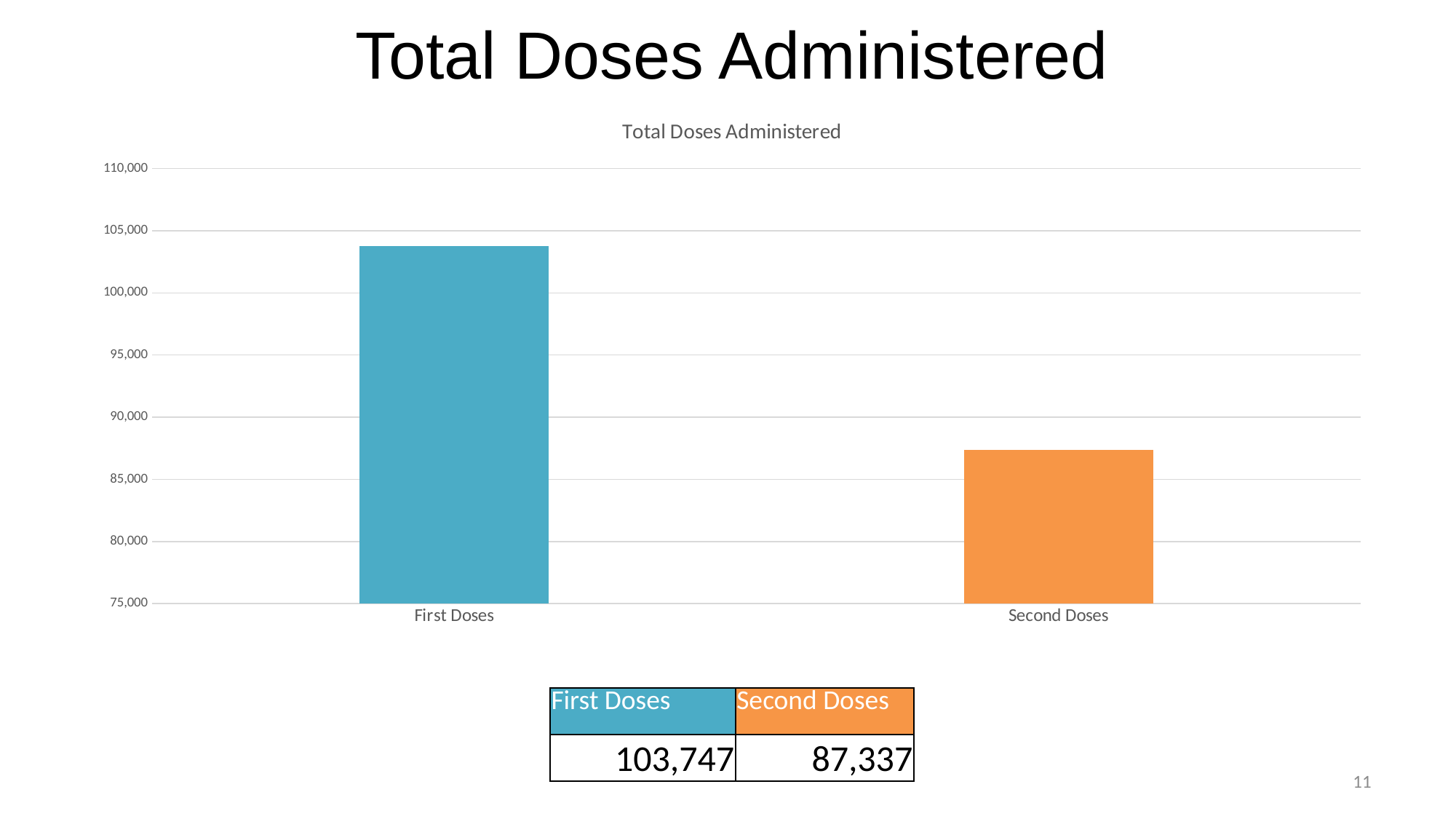
What colour is the bar for Second Doses? orange What is the title of the chart? Total Doses Administered What kind of chart is shown on the slide? bar chart Which is larger, First Doses or Second Doses? First Doses Is the value for First Doses greater or less than 100,000? greater Is the value for Second Doses greater or less than 90,000? less How many categories are shown in the chart? 2 Which category has the lowest value? Second Doses What is the value for First Doses? 103,747 What is the difference between First Doses and Second Doses? 16,410 Which category has the highest value? First Doses What is the value for Second Doses? 87,337